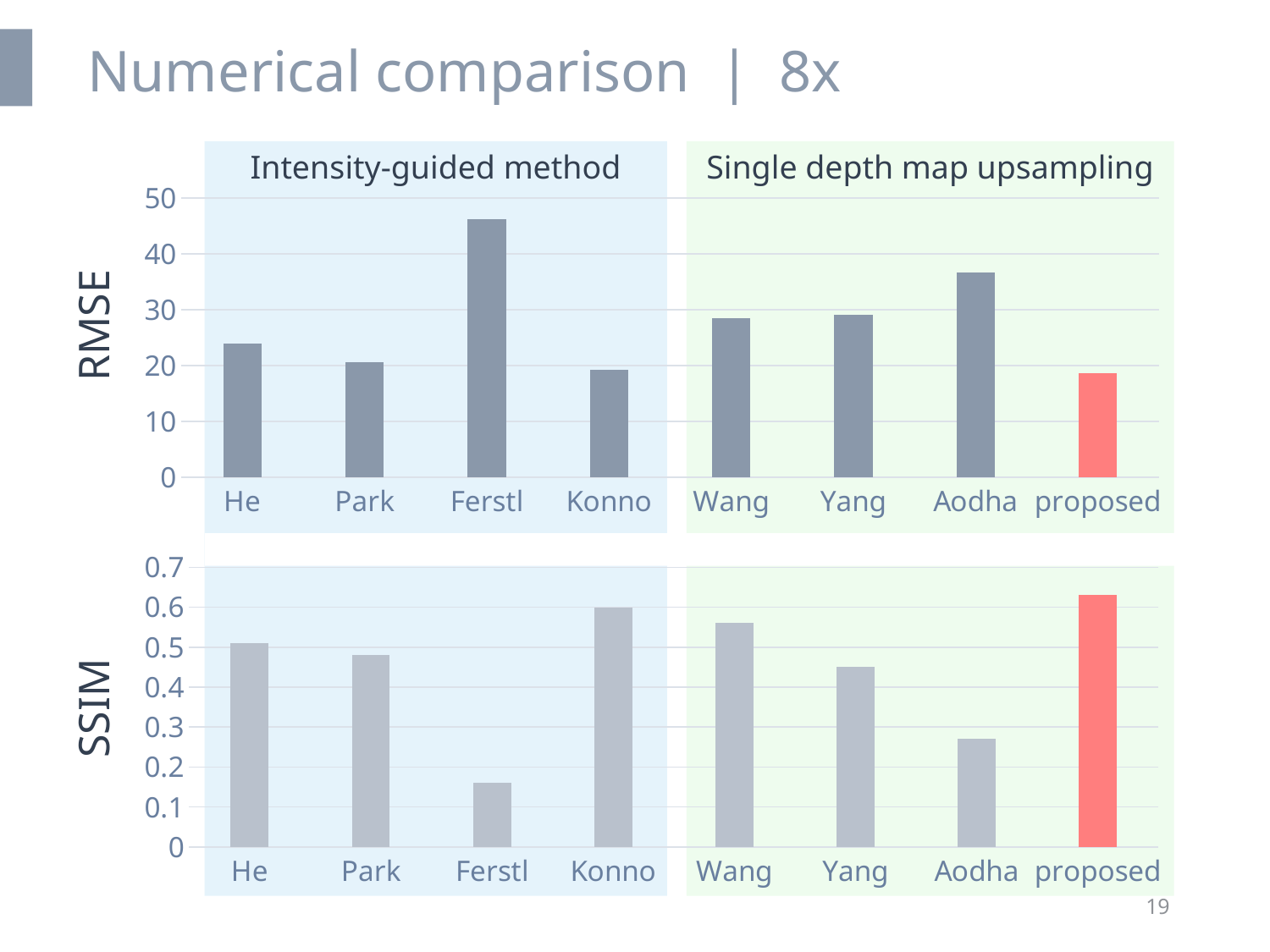
In the SSIM chart, is the value for Aodha greater or less than 0.3? less What kind of chart is the RMSE chart at the top of the slide? bar chart In the RMSE chart, is the value for Aodha greater or less than 30? greater In the RMSE chart, which has the larger RMSE, Ferstl or Aodha? Ferstl In the SSIM chart, which method has the highest SSIM? proposed In the SSIM chart, is the value for Ferstl greater or less than 0.2? less In the SSIM chart, which method has the lowest SSIM? Ferstl How many methods (categories) are plotted in the RMSE chart? 8 In the SSIM chart, which bar is highlighted in red/pink rather than grey? proposed In the RMSE chart, which method has the highest RMSE? Ferstl